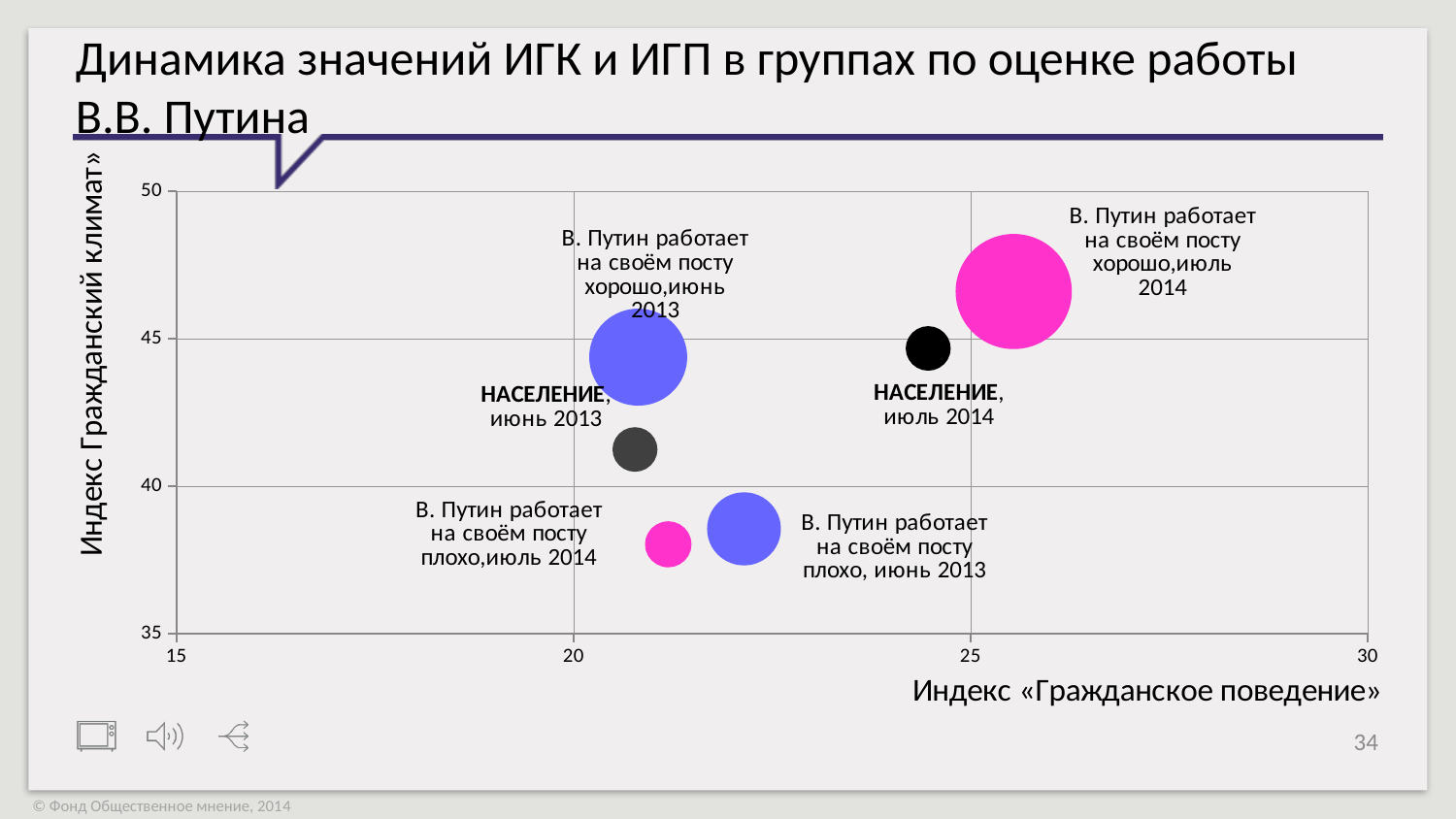
What kind of chart is shown on the slide? bubble chart Is the horizontal-axis value for «В. Путин работает на своём посту хорошо, июль 2014» greater or less than 25? greater Which has the larger horizontal-axis value: «НАСЕЛЕНИЕ, июль 2014» or «НАСЕЛЕНИЕ, июнь 2013»? НАСЕЛЕНИЕ, июль 2014 Which has the higher vertical-axis value: «НАСЕЛЕНИЕ, июль 2014» or «НАСЕЛЕНИЕ, июнь 2013»? НАСЕЛЕНИЕ, июль 2014 Is the horizontal-axis value for «НАСЕЛЕНИЕ, июнь 2013» greater or less than 25? less Which group has the highest value on the vertical axis (Индекс «Гражданский климат»)? В. Путин работает на своём посту хорошо, июль 2014 Is the vertical-axis value for «В. Путин работает на своём посту хорошо, июль 2014» greater or less than 45? greater How many bubbles are plotted on the chart? 6 What is the title of the horizontal axis? Индекс «Гражданское поведение» Which group has the highest value on the horizontal axis (Индекс «Гражданское поведение»)? В. Путин работает на своём посту хорошо, июль 2014